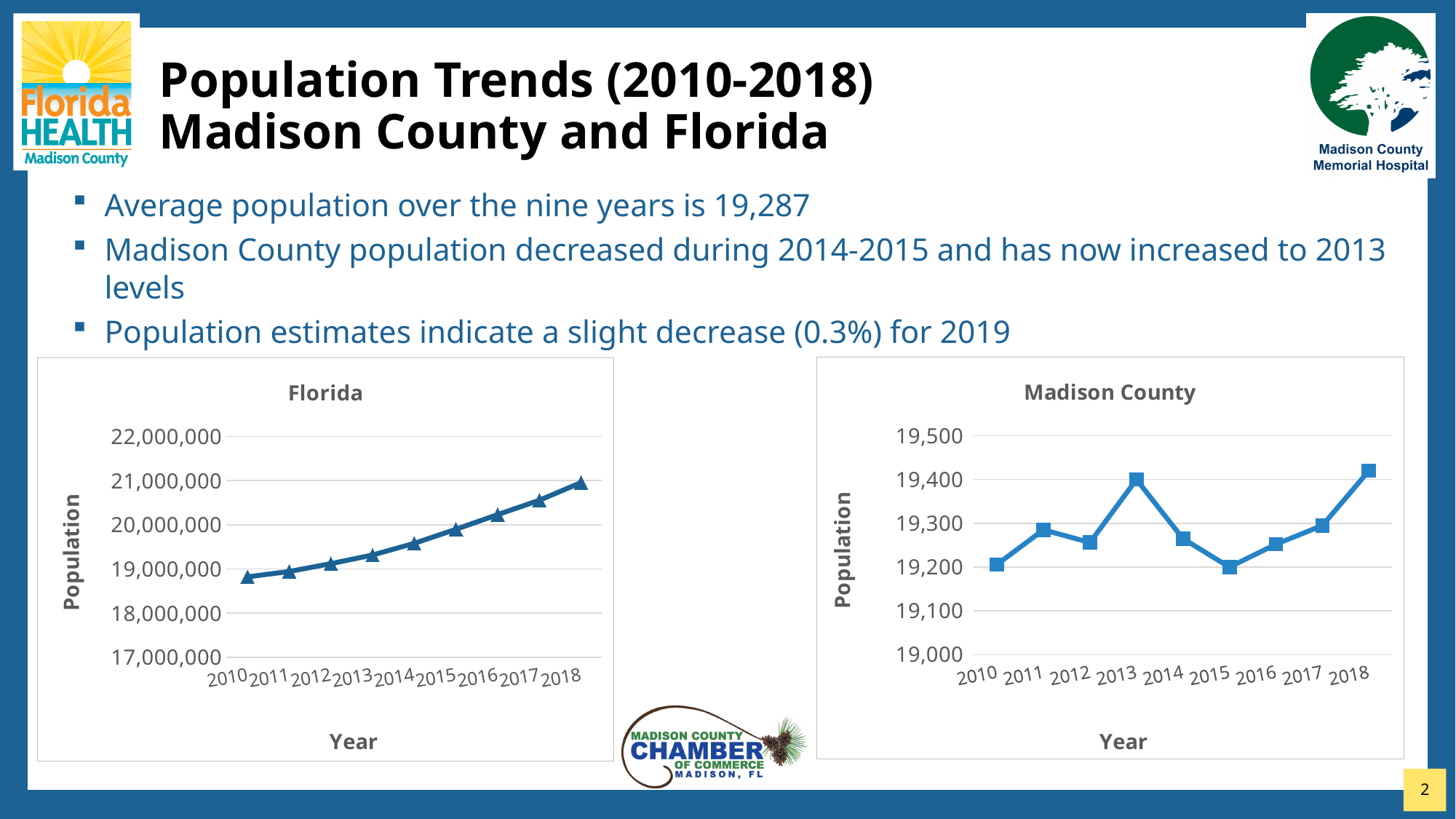
How many years are plotted on the Florida chart? 9 What kind of chart is the Madison County chart? line chart On the Madison County chart, which is larger, the value for 2013 or the value for 2015? 2013 How many years are plotted on the Madison County chart? 9 On the Florida chart, which year has the lowest population? 2010 On the Florida chart, is the value for 2018 greater or less than 20,000,000? greater On the Florida chart, does the population rise or fall from 2010 to 2018? rise On the Madison County chart, is the value for 2015 greater or less than 19,300? less On the Florida chart, is the value for 2010 greater or less than 19,000,000? less What kind of chart is the Florida chart? line chart On the Florida chart, which year has the highest population? 2018 What is the label on the y axis of the Madison County chart? Population